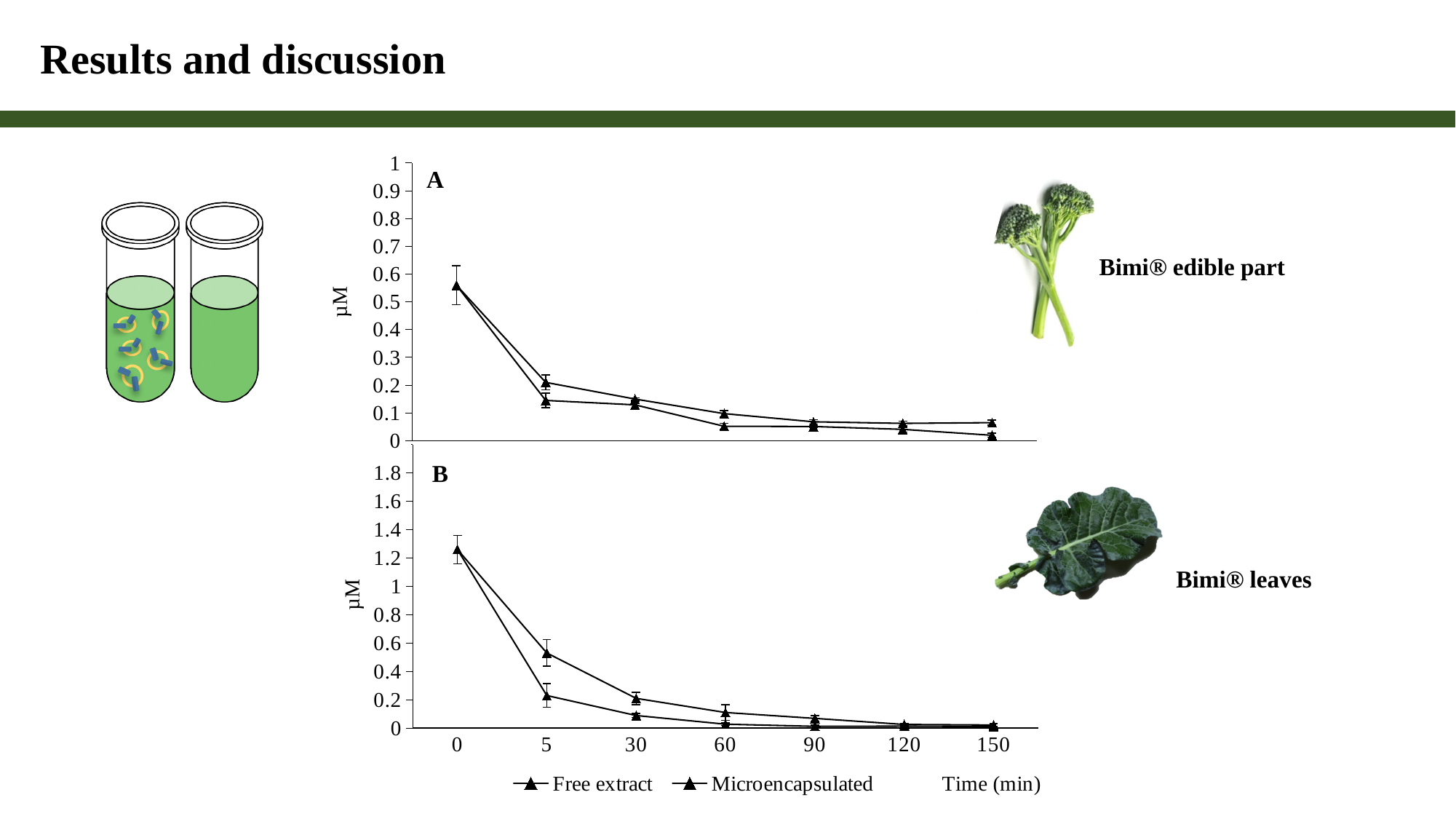
In chart B (Bimi® leaves), at which time point are the values highest? 0 In chart B (Bimi® leaves), do the values rise or fall as time increases? fall How many time points are plotted along the x axis of chart B (Bimi® leaves)? 7 In chart A (Bimi® edible part), at which time point are the values highest? 0 In chart A (Bimi® edible part), do the values rise or fall as time increases? fall What kind of chart is chart A (Bimi® edible part)? line chart What kind of chart is chart B (Bimi® leaves)? line chart What are the two series named in the legend? Free extract and Microencapsulated In chart B (Bimi® leaves), are the values at time 150 greater or less than 0.2? less In chart B (Bimi® leaves), is the value at time 0 greater or less than 1? greater How many series does the legend list for the charts? 2 In chart A (Bimi® edible part), is the value at time 0 greater or less than 0.5? greater